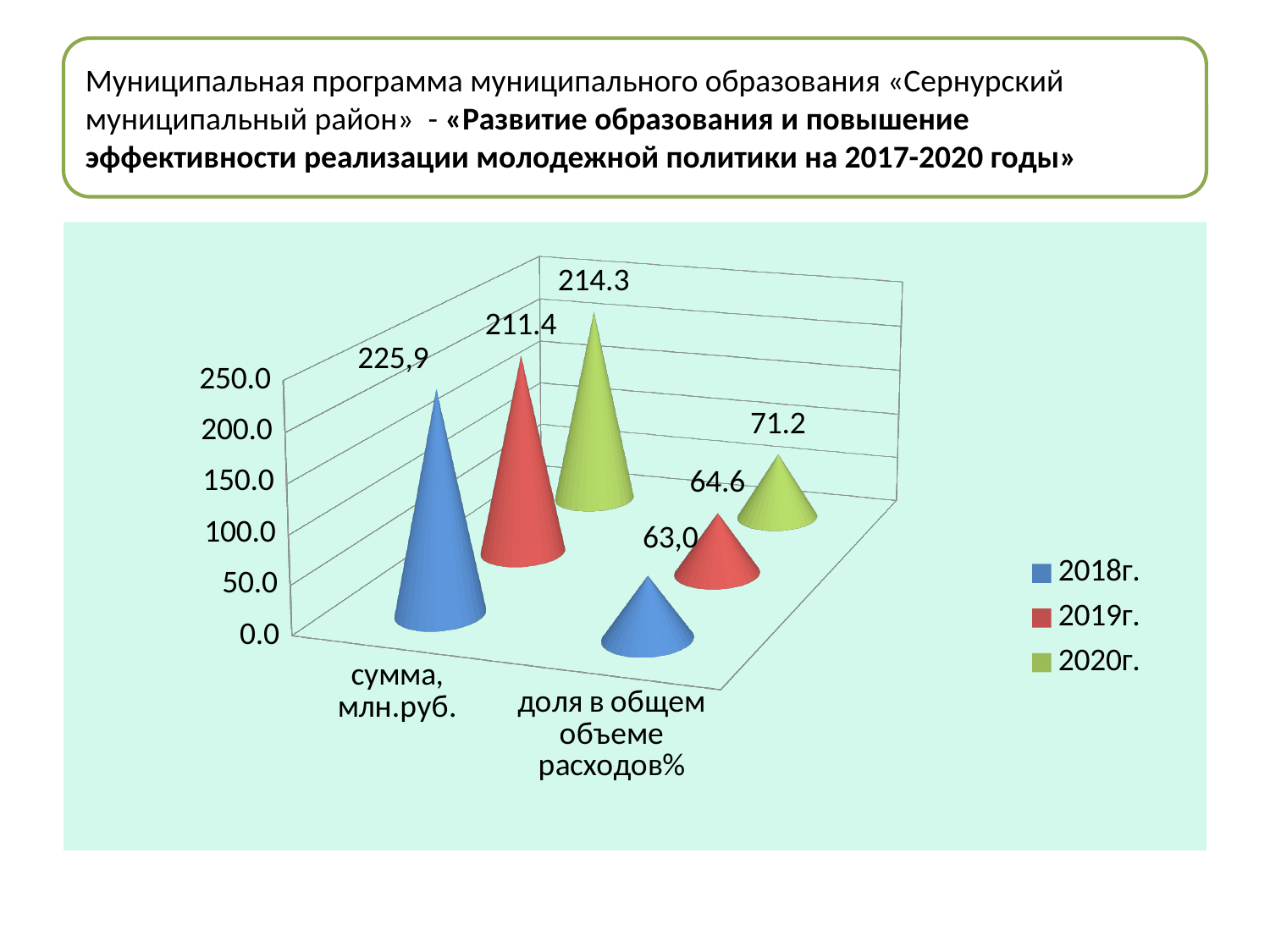
Which is larger in the category «сумма, млн.руб.»: the value for 2019г. or for 2020г.? 2020г. What kind of chart is shown on the slide? bar chart Which year has the highest value in the category «сумма, млн.руб.»? 2018г. What is the difference between the 2020г. and 2019г. values in the category «доля в общем объеме расходов%»? 6.6 What is the value for 2018г. in the category «сумма, млн.руб.»? 225,9 How many categories are shown on the x axis? 2 What is the value for 2019г. in the category «сумма, млн.руб.»? 211.4 Which year has the lowest value in the category «доля в общем объеме расходов%»? 2018г. How many series does the legend list? 3 What is the value for 2020г. in the category «доля в общем объеме расходов%»? 71.2 What is the difference between the 2018г. and 2019г. values in the category «сумма, млн.руб.»? 14.5 What is the value for 2018г. in the category «доля в общем объеме расходов%»? 63,0